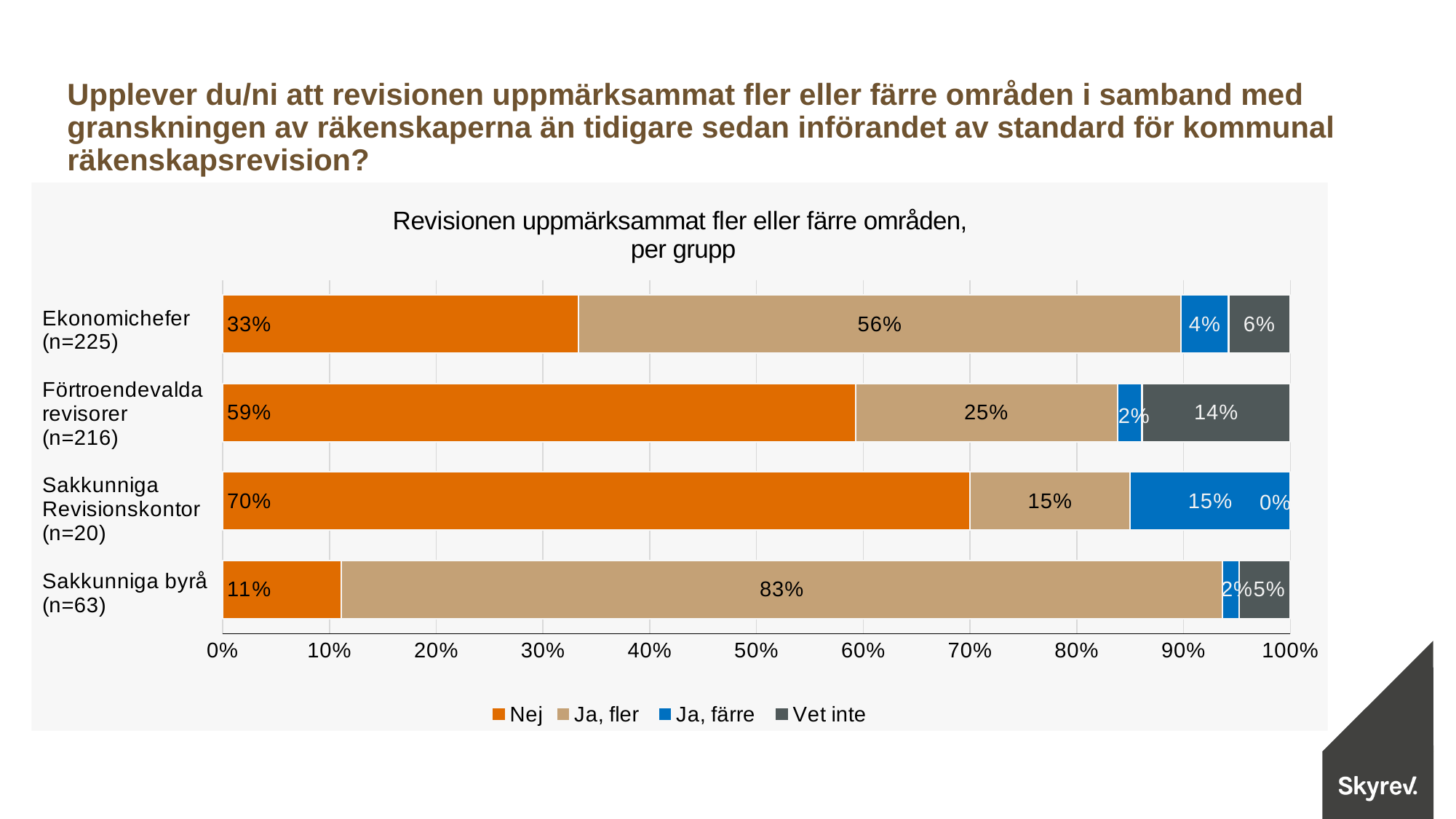
What is the title of the chart? Revisionen uppmärksammat fler eller färre områden, per grupp What percentage of Sakkunniga byrå (n=63) answered "Nej"? 11% What kind of chart is shown on the slide? Stacked bar chart Which group has the lowest share of "Ja, fler" answers? Sakkunniga Revisionskontor (n=20) What percentage of Ekonomichefer (n=225) answered "Ja, fler"? 56% Which group has the highest share of "Nej" answers? Sakkunniga Revisionskontor (n=20) What percentage of Sakkunniga Revisionskontor (n=20) answered "Ja, färre"? 15% What percentage of Förtroendevalda revisorer (n=216) answered "Vet inte"? 14% How many groups (categories) are shown in the chart? 4 Which is larger: the "Ja, fler" share for Sakkunniga byrå (n=63) or for Ekonomichefer (n=225)? Sakkunniga byrå (n=63) What is the difference between the "Nej" share for Förtroendevalda revisorer (n=216) and for Ekonomichefer (n=225)? 26% How many series does the legend list? 4